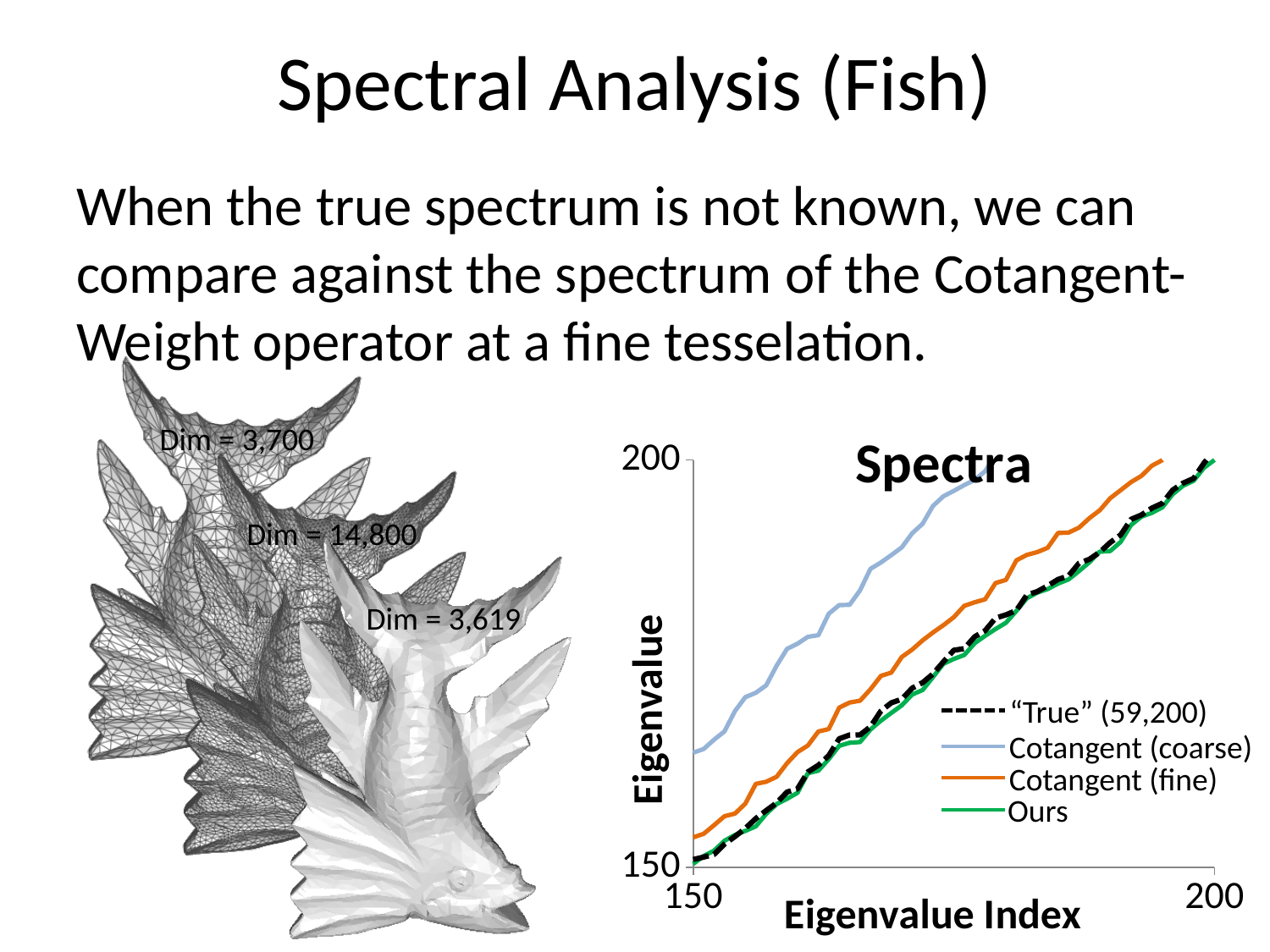
What is the lowest value shown on the y axis of the chart? 150 Do the eigenvalues rise or fall as the eigenvalue index increases? rise What is the title of the chart? Spectra What kind of chart is shown on the slide? line chart Is the value of Ours at eigenvalue index 200 greater or less than 175? greater How many series does the chart's legend list? 4 What is the label of the x axis of the chart? Eigenvalue Index Is the value of Cotangent (coarse) at eigenvalue index 150 greater or less than 150? greater Which series is larger at a given eigenvalue index, Cotangent (fine) or Ours? Cotangent (fine) Which series is larger at a given eigenvalue index, Cotangent (coarse) or Cotangent (fine)? Cotangent (coarse) Which series has the highest eigenvalues across the plotted index range? Cotangent (coarse)